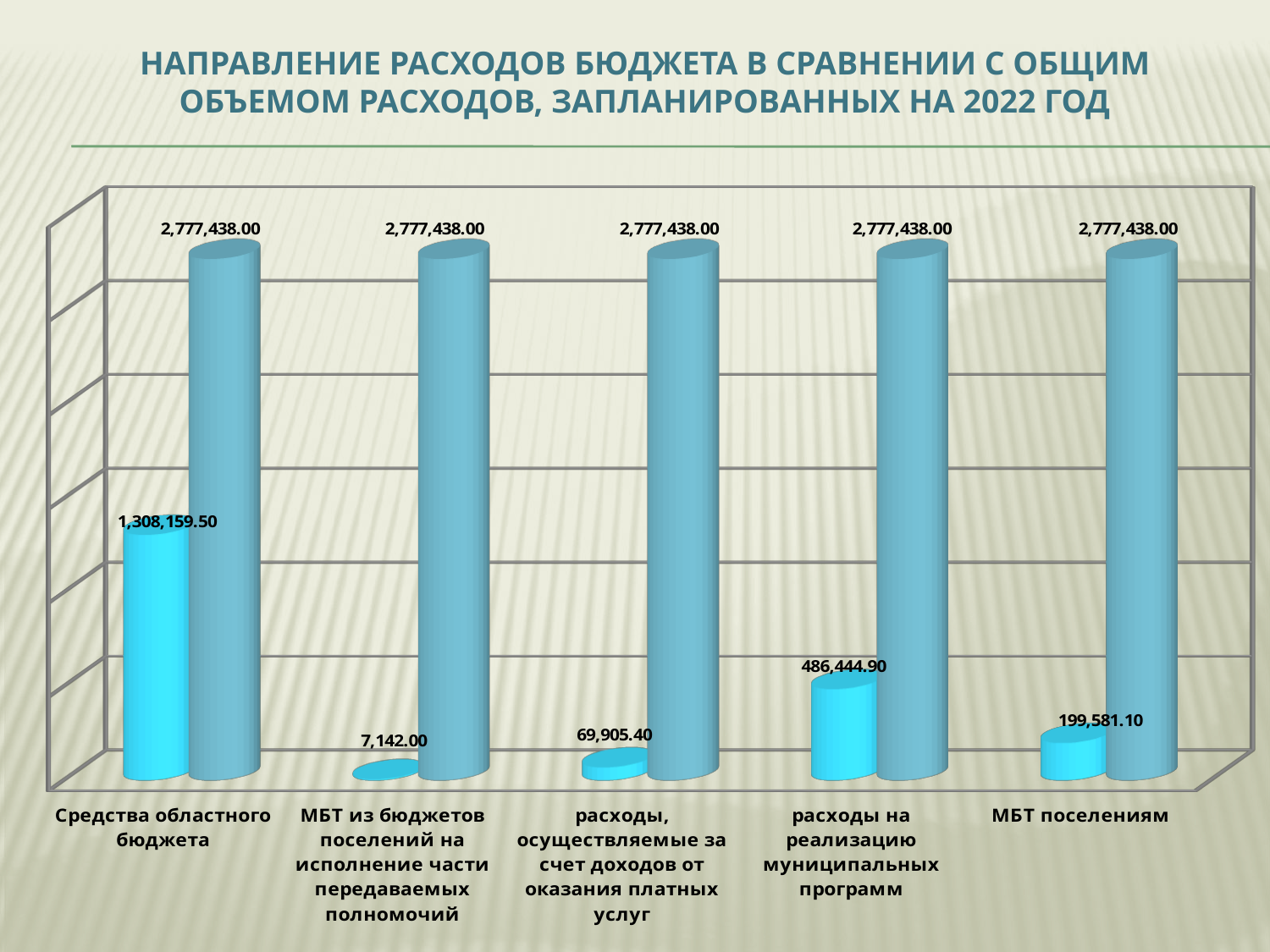
What is the value of the smaller bar for 'расходы, осуществляемые за счет доходов от оказания платных услуг'? 69,905.40 What type of chart is shown on the slide? Bar chart What value is shown for the taller bar in every category? 2,777,438.00 What is the value of the smaller bar for 'расходы на реализацию муниципальных программ'? 486,444.90 Which is larger: the smaller bar for 'расходы на реализацию муниципальных программ' or the smaller bar for 'МБТ поселениям'? расходы на реализацию муниципальных программ What is the value of the smaller bar for 'МБТ поселениям'? 199,581.10 Which category has the lowest value among the smaller (light blue) bars? МБТ из бюджетов поселений на исполнение части передаваемых полномочий Which category has the highest value among the smaller (light blue) bars? Средства областного бюджета What is the difference between the taller bar (2,777,438.00) and the smaller bar for 'Средства областного бюджета'? 1,469,278.50 What is the value of the smaller bar for 'МБТ из бюджетов поселений на исполнение части передаваемых полномочий'? 7,142.00 How many categories are shown on the x axis of the chart? 5 What is the value of the smaller (light blue) bar for 'Средства областного бюджета'? 1,308,159.50